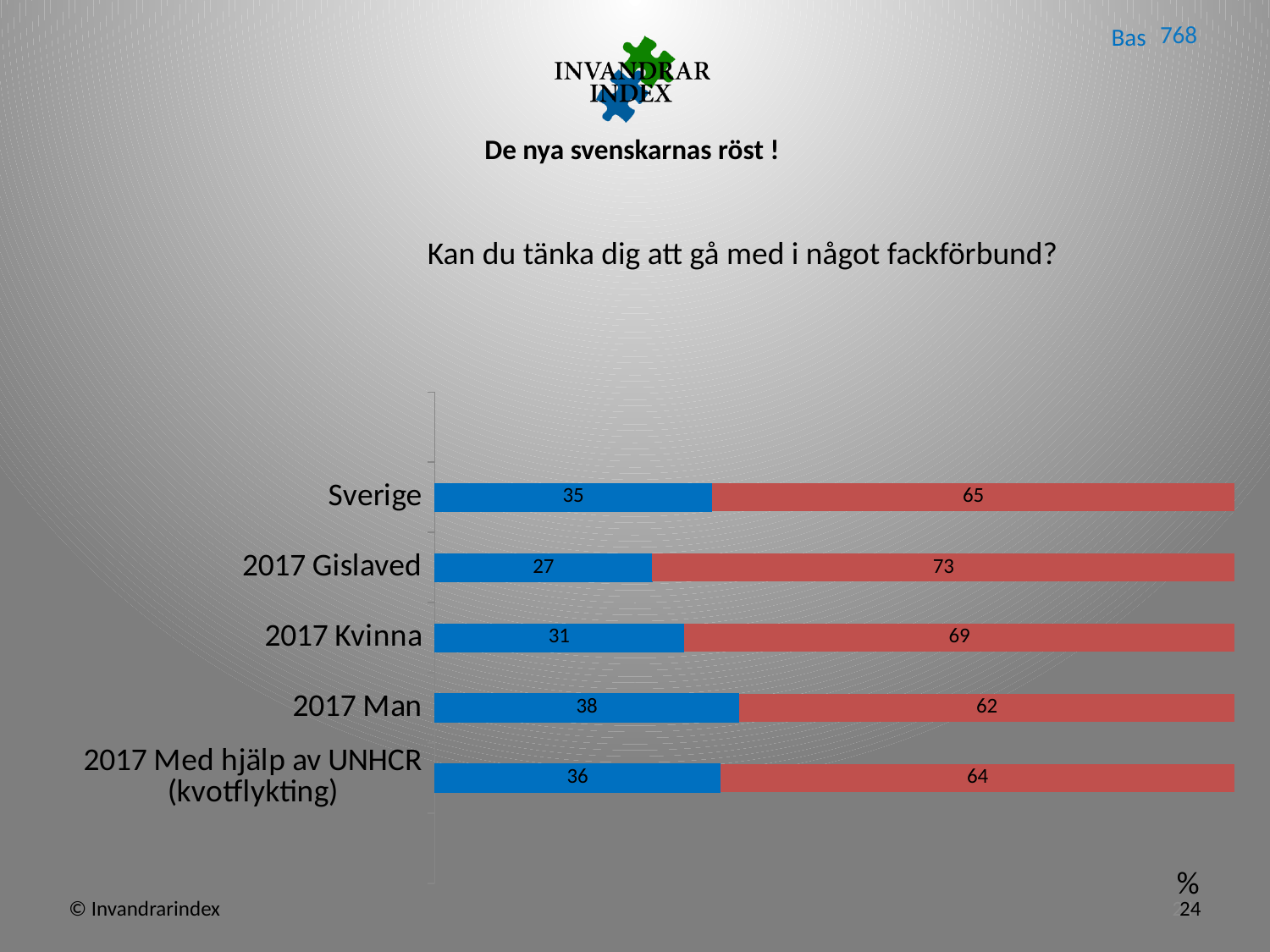
What is the total of the stacked bar for 2017 Kvinna? 100 What is the value of the red segment for 2017 Man? 62 Which category has the highest blue segment value? 2017 Man Which is larger, the blue segment for Sverige or the blue segment for 2017 Gislaved? Sverige What is the value of the blue segment for 2017 Kvinna? 31 What is the value of the blue segment for 2017 Med hjälp av UNHCR (kvotflykting)? 36 Which category has the lowest blue segment value? 2017 Gislaved How many categories are shown in the chart? 5 What is the value of the blue segment for Sverige? 35 What is the value of the red segment for 2017 Gislaved? 73 What is the difference between the blue segment values for 2017 Man and 2017 Kvinna? 7 What type of chart is shown on the slide? Stacked bar chart